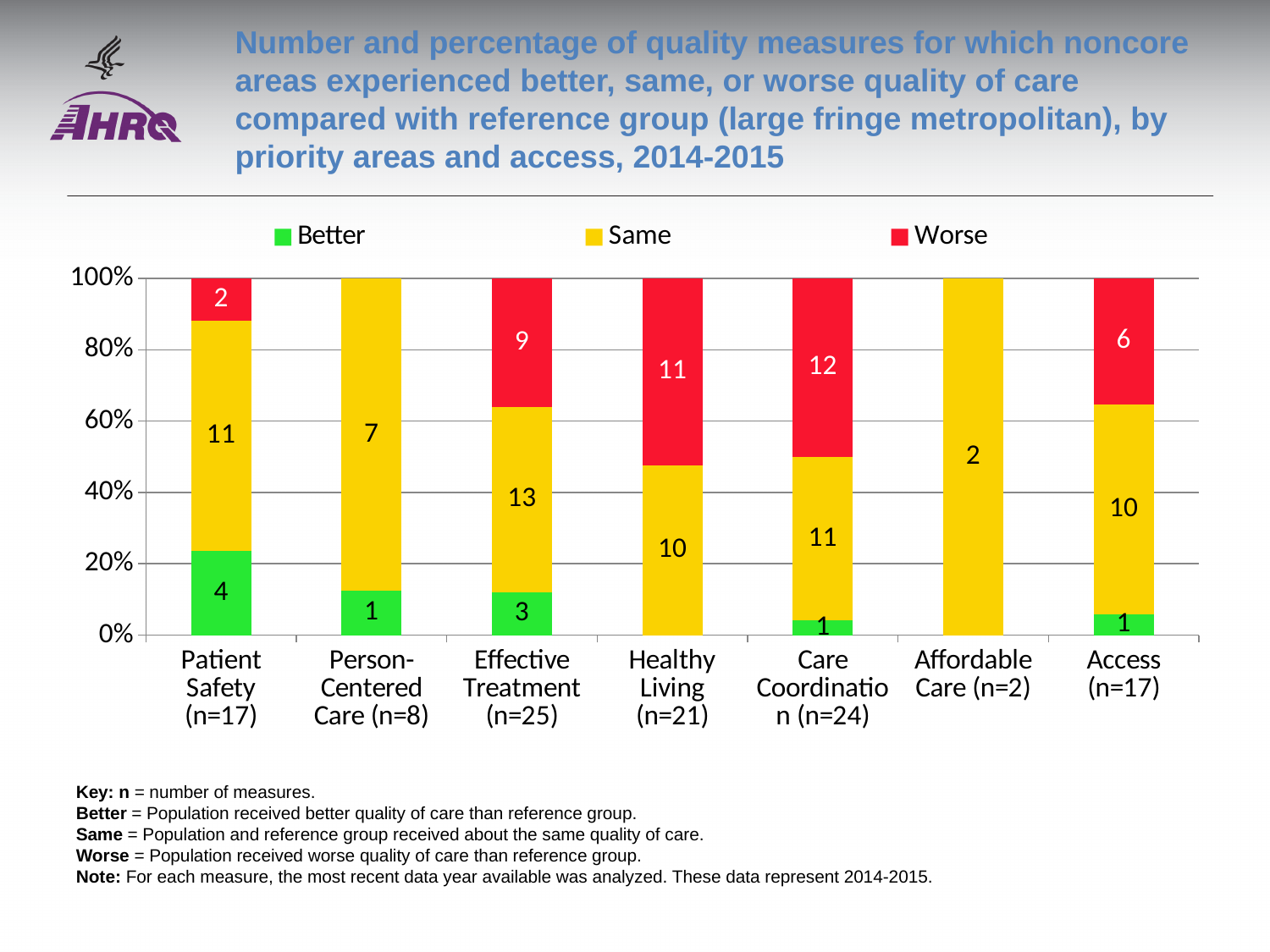
Which colour represents the "Worse" series in the chart? Red What is the total number of measures across the three segments of the Patient Safety bar? 17 How many "Better" measures are shown for Patient Safety? 4 How many measures are labeled as "Same" for Effective Treatment? 13 What kind of chart is shown on the slide? Stacked bar chart What is the difference between the "Same" and "Worse" counts for Access? 4 Which category has the highest number of "Better" measures? Patient Safety (n=17) What is the number of "Worse" measures shown for Healthy Living? 11 Which category has the highest number of "Worse" measures? Care Coordination (n=24) How many categories are shown on the x axis? 7 Which is larger for Care Coordination: the "Same" count or the "Worse" count? Worse How many series does the legend list? 3